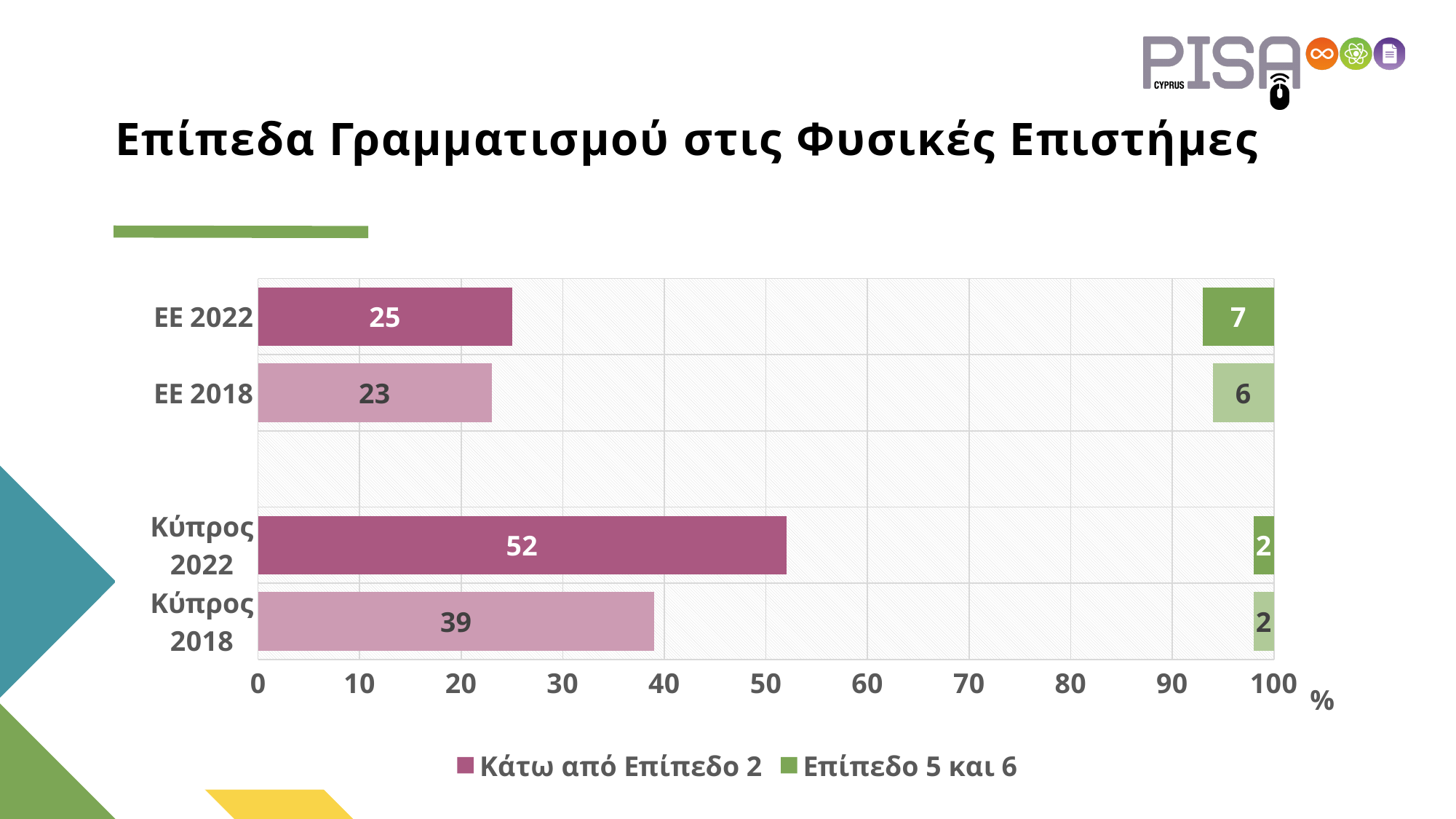
What kind of chart is shown on the slide? Bar chart What is the value for Κύπρος 2018 in the 'Επίπεδο 5 και 6' series? 2 Which category has the highest value in the 'Επίπεδο 5 και 6' series? ΕΕ 2022 Which category has the highest value in the 'Κάτω από Επίπεδο 2' series? Κύπρος 2022 What is the value for ΕΕ 2018 in the 'Επίπεδο 5 και 6' series? 6 What is the value for ΕΕ 2022 in the 'Κάτω από Επίπεδο 2' series? 25 What is the difference between the 'Κάτω από Επίπεδο 2' values for Κύπρος 2022 and Κύπρος 2018? 13 How many categories are shown on the chart? 4 What is the value for Κύπρος 2022 in the 'Κάτω από Επίπεδο 2' series? 52 Which category has the lowest value in the 'Κάτω από Επίπεδο 2' series? ΕΕ 2018 How many series does the legend list? 2 Which is larger: the 'Κάτω από Επίπεδο 2' value for ΕΕ 2022 or for Κύπρος 2018? Κύπρος 2018